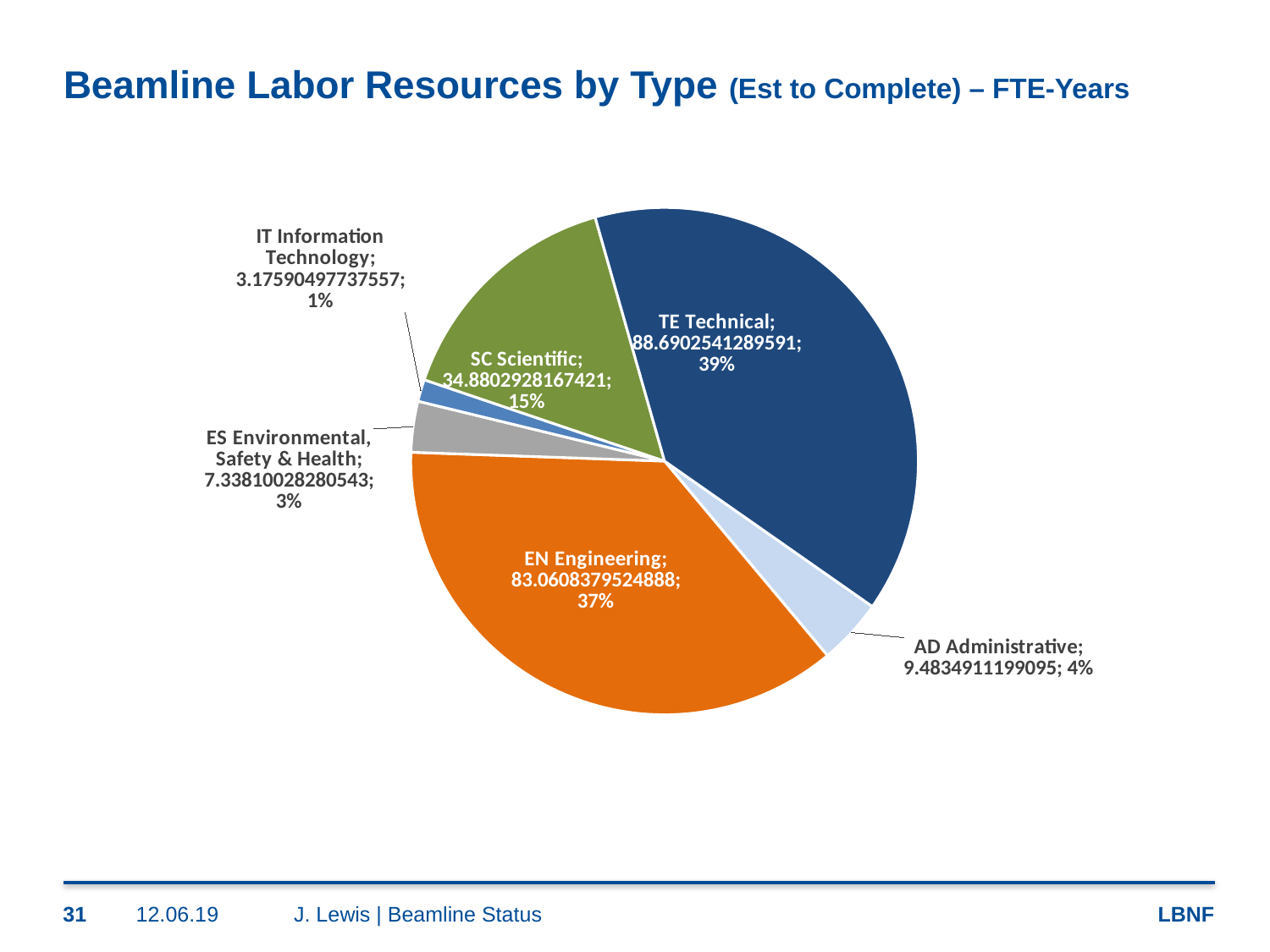
What kind of chart is shown on the slide? pie chart What is the value for SC Scientific? 34.8802928167421 What share of the pie does ES Environmental, Safety & Health represent? 3% What is the title of the chart? Beamline Labor Resources by Type (Est to Complete) – FTE-Years What is the value for EN Engineering? 83.0608379524888 How many slices does the pie chart have? 6 Which is larger, the share for AD Administrative or the share for ES Environmental, Safety & Health? AD Administrative What is the value for TE Technical? 88.6902541289591 What share of the pie does SC Scientific represent? 15% Which category has the largest slice? TE Technical Which category has the smallest slice? IT Information Technology What is the value for AD Administrative? 9.4834911199095